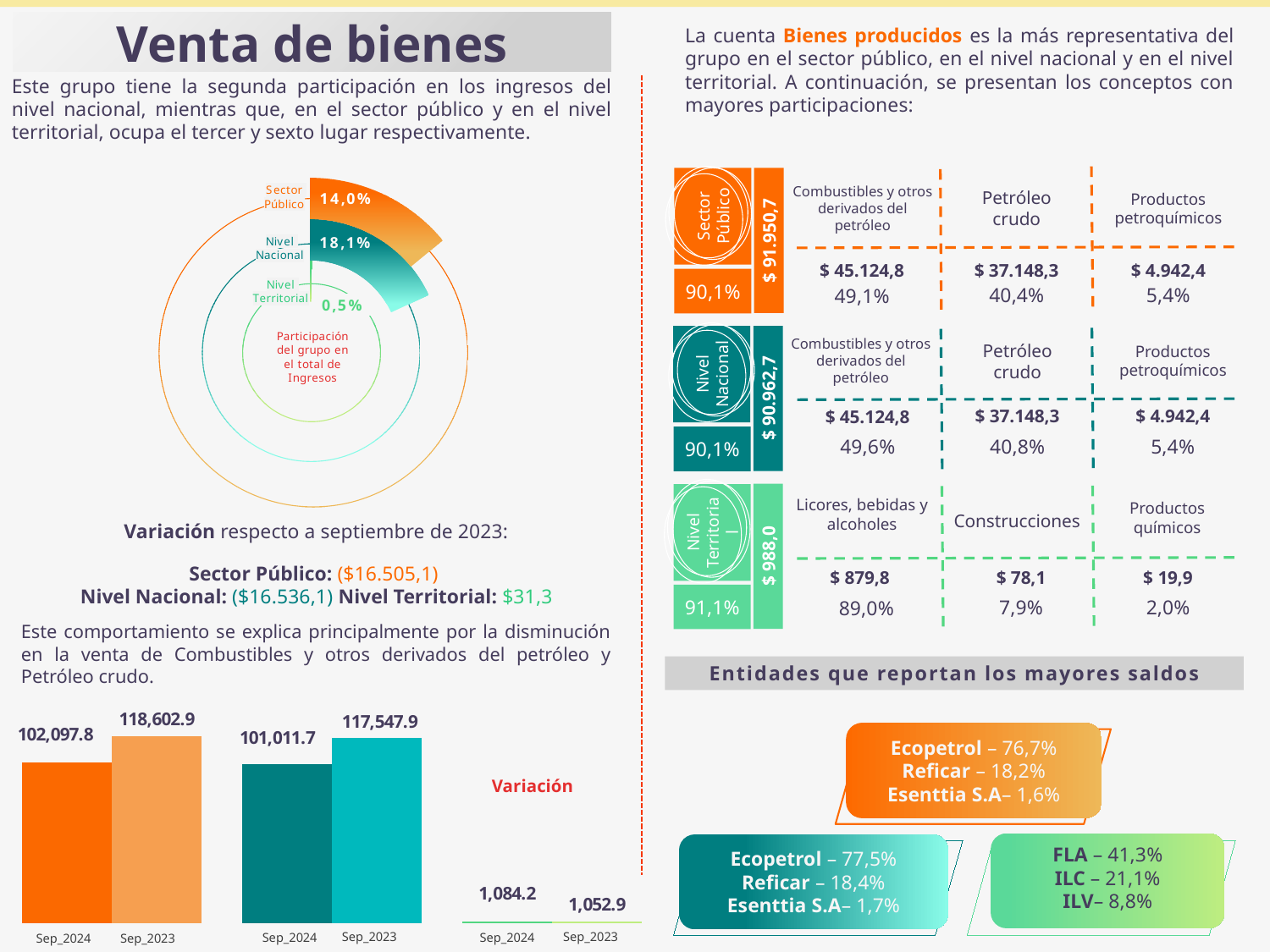
In the radial chart on the upper left, which category has the lowest value? Nivel Territorial In the bar chart at the bottom left, what is the difference between the Sep_2024 and Sep_2023 values in the rightmost (green) group? 31.3 In the radial chart on the upper left, what is the value shown for Nivel Nacional? 18,1% In the radial chart on the upper left, which category has the highest value? Nivel Nacional In the bar chart at the bottom left, what is the Sep_2024 value in the leftmost (orange) group? 102,097.8 In the bar chart at the bottom left, what is the difference between the Sep_2023 and Sep_2024 values in the leftmost (orange) group? 16,505.1 In the radial chart on the upper left, what is the value shown for Sector Público? 14,0% In the bar chart at the bottom left, what is the Sep_2023 value in the middle (teal) group? 117,547.9 In the radial chart on the upper left, what is the value shown for Nivel Territorial? 0,5% In the bar chart at the bottom left, which is larger in the rightmost (green) group: Sep_2024 or Sep_2023? Sep_2024 What kind of chart is shown at the bottom left of the slide? Bar chart In the radial chart on the upper left, how many categories are plotted? 3